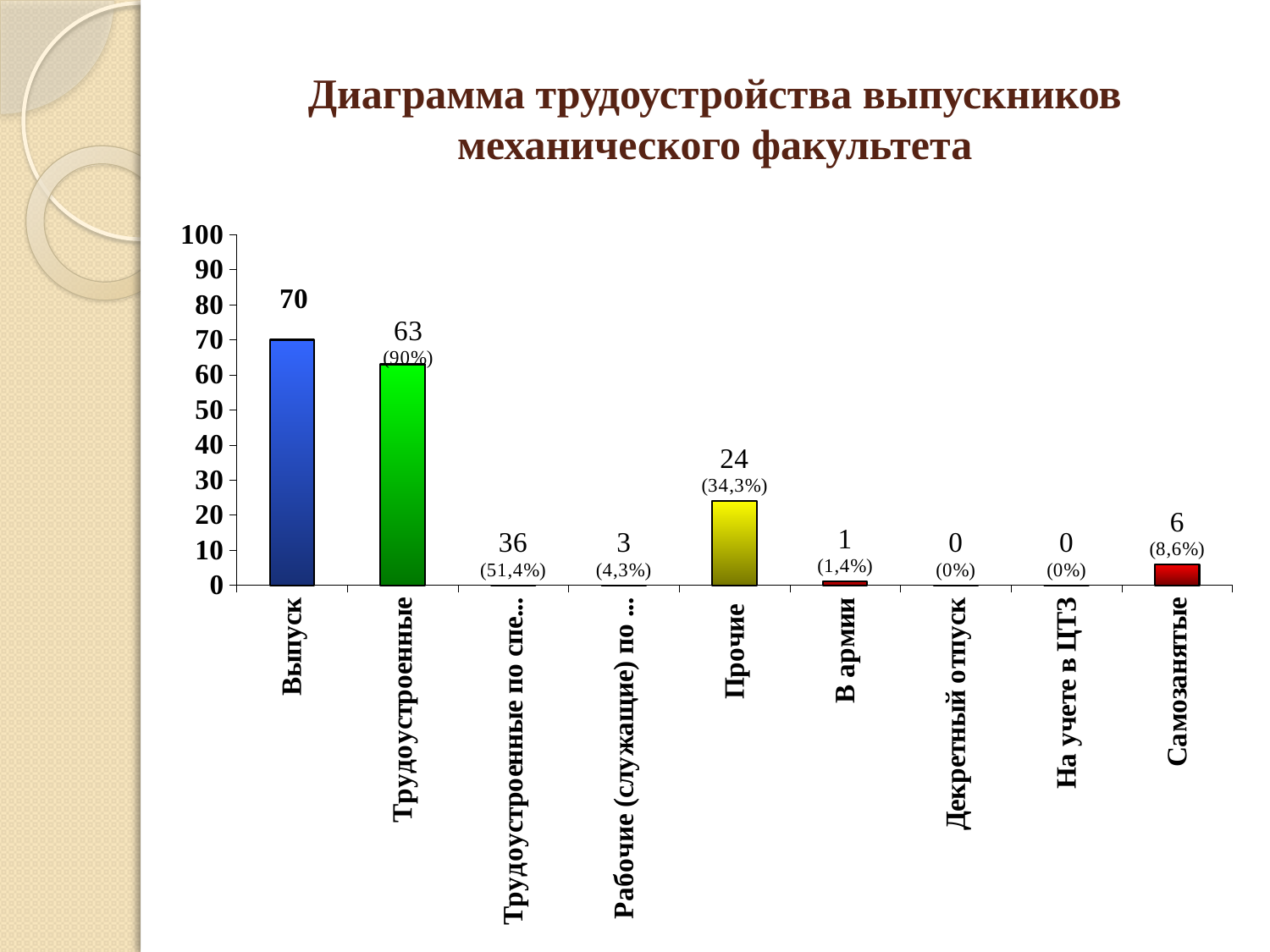
What is the difference between the values for Выпуск and Трудоустроенные? 7 What is the value for Трудоустроенные? 63 What percentage is shown for В армии? 1,4% What is the value for Самозанятые? 6 What is the title of the chart? Диаграмма трудоустройства выпускников механического факультета What is the difference between the values for Прочие and Самозанятые? 18 What is the value for Выпуск? 70 How many categories are shown on the x axis? 9 Which is larger, the value for Прочие or the value for Самозанятые? Прочие What percentage is shown for Прочие? 34,3% What kind of chart is shown on the slide? Bar chart Which category has the highest value? Выпуск